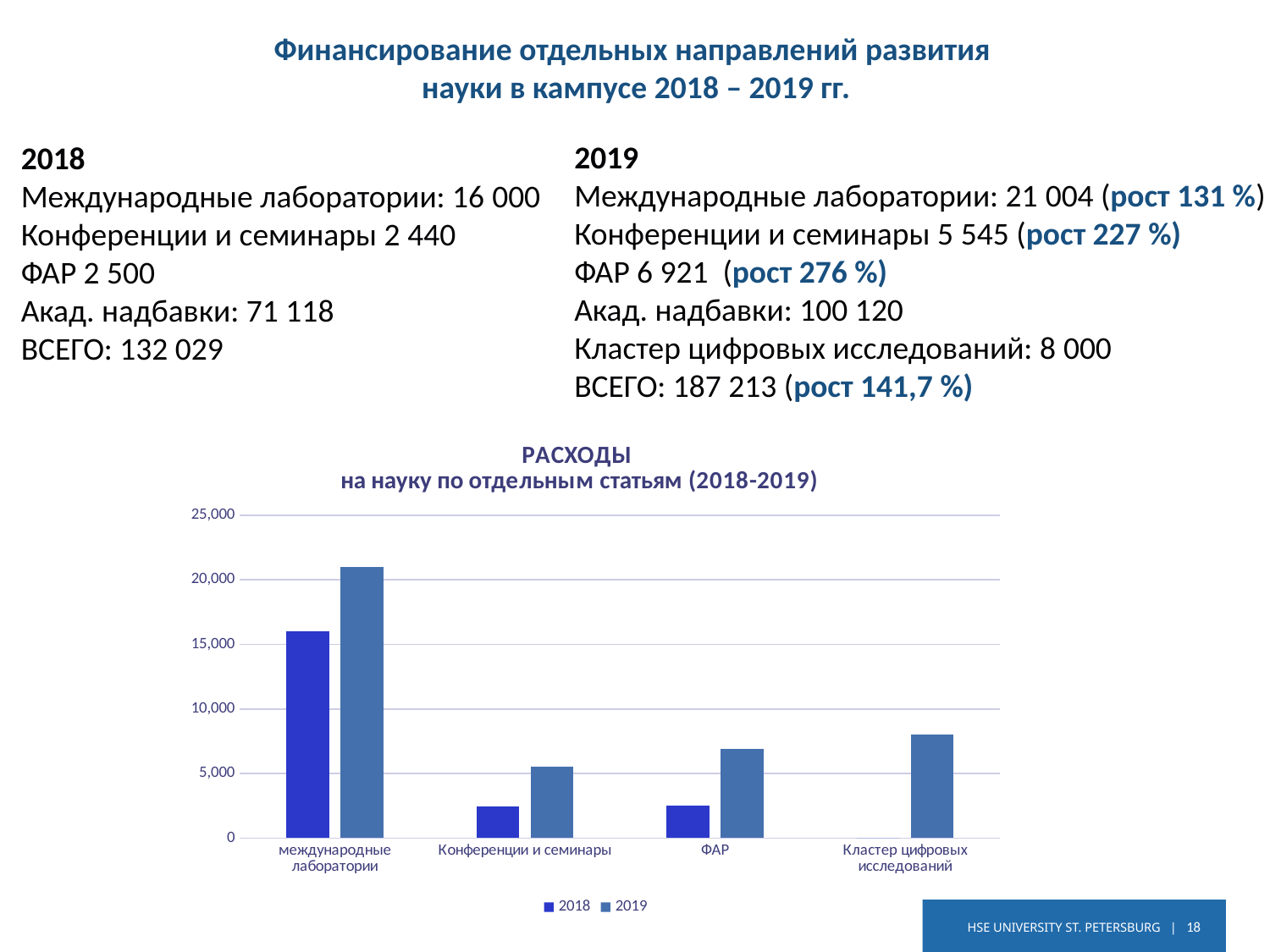
Which category has the highest bar for the 2019 series? международные лаборатории How many series does the chart legend list? 2 Is the 2019 value for ФАР greater or less than 10,000? less Is the 2018 value for ФАР greater or less than 5,000? less In the 2019 series, which is larger: ФАР or Кластер цифровых исследований? Кластер цифровых исследований Is the 2019 value for Кластер цифровых исследований greater or less than 10,000? less For ФАР, which series has the larger bar, 2018 or 2019? 2019 Which category has the lowest bar for the 2019 series? Конференции и семинары How many categories are shown on the x axis of the chart? 4 Which category has no bar for the 2018 series? Кластер цифровых исследований What kind of chart is shown on the slide? bar chart